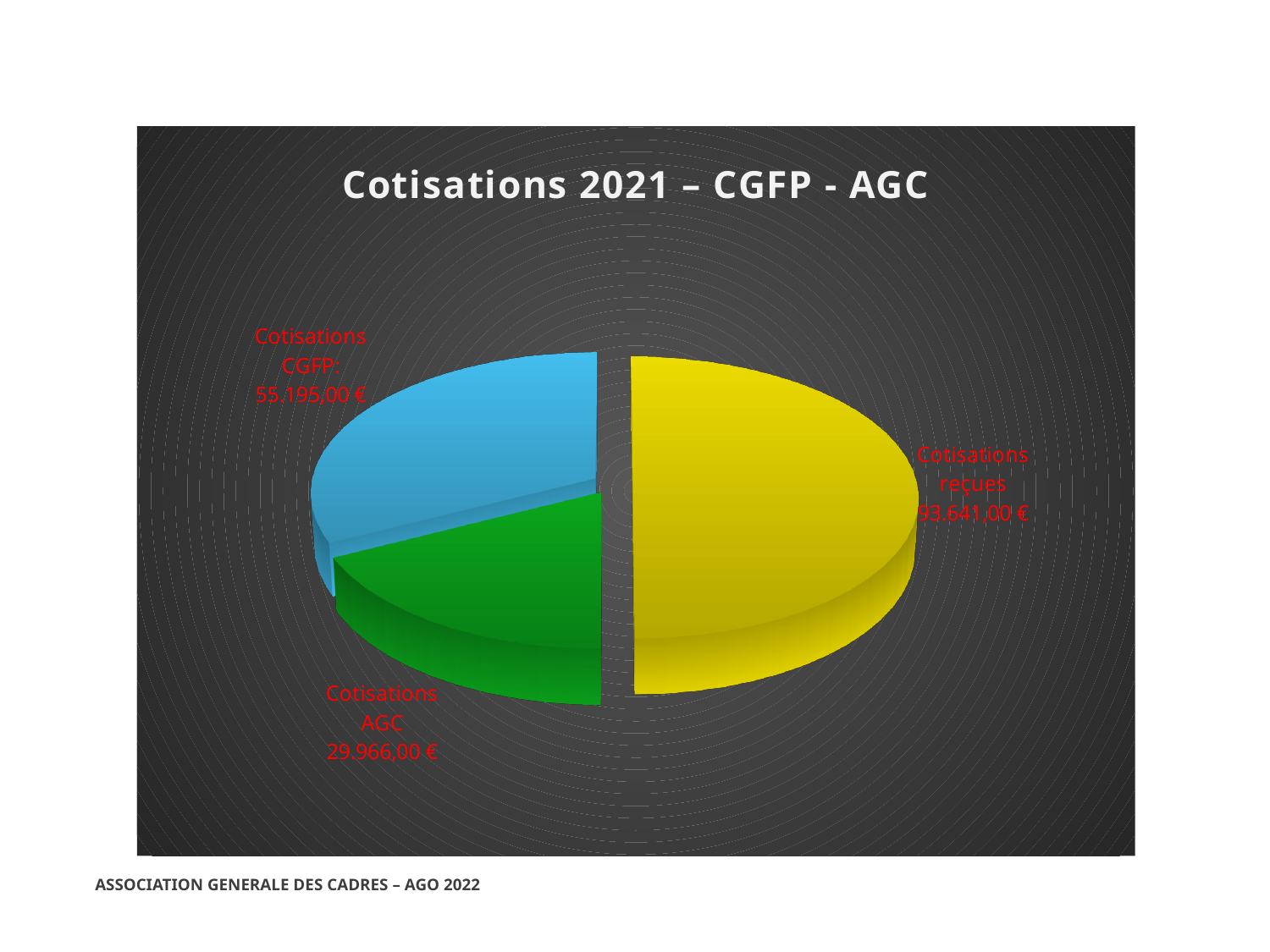
What is the difference between Cotisations reçues and Cotisations CGFP? 38.446,00 € What colour is the Cotisations reçues slice? Yellow What is the value shown for Cotisations AGC? 29.966,00 € What is the title of the chart? Cotisations 2021 – CGFP - AGC Which slice has the smallest value? Cotisations AGC What is the value shown for Cotisations reçues? 93.641,00 € How many slices does the pie chart have? 3 What is the value shown for Cotisations CGFP? 55.195,00 € Which slice has the largest value? Cotisations reçues What is the difference between Cotisations CGFP and Cotisations AGC? 25.229,00 € Which is larger, Cotisations CGFP or Cotisations AGC? Cotisations CGFP What type of chart is shown on the slide? Pie chart